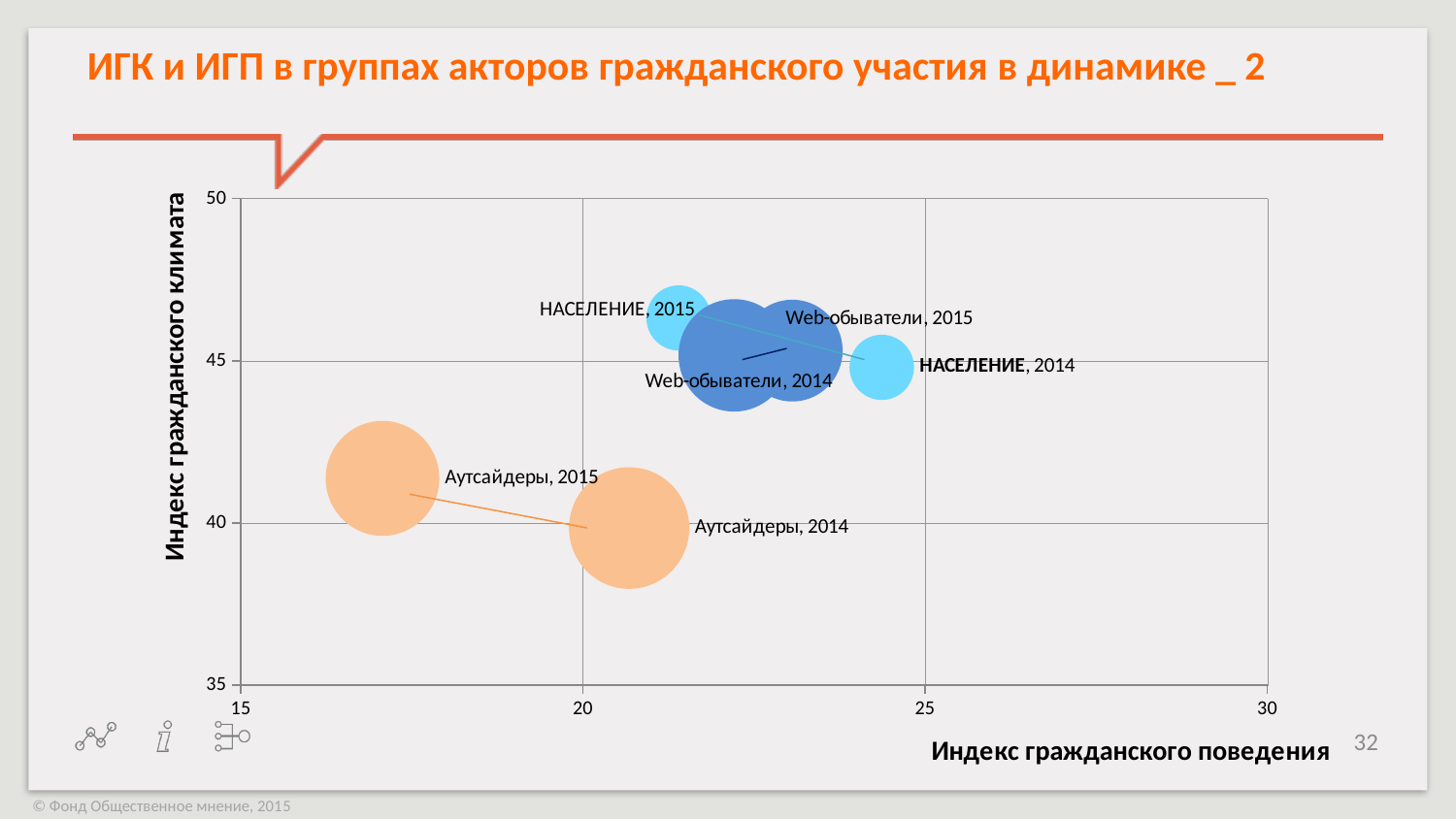
Which has the larger value on the x axis: НАСЕЛЕНИЕ, 2014 or НАСЕЛЕНИЕ, 2015? НАСЕЛЕНИЕ, 2014 Is the value on the y axis for НАСЕЛЕНИЕ, 2015 greater or less than 45? greater Is the value on the x axis (Индекс гражданского поведения) for Аутсайдеры, 2015 greater or less than 20? less Is the value on the y axis (Индекс гражданского климата) for Аутсайдеры, 2015 greater or less than 40? greater How many bubbles (data points) are plotted on the chart? 6 What kind of chart is shown on the slide? bubble chart What is the title of the horizontal axis? Индекс гражданского поведения Which bubble has the lowest value on the x axis (Индекс гражданского поведения)? Аутсайдеры, 2015 Which bubble has the lowest value on the y axis (Индекс гражданского климата)? Аутсайдеры, 2014 Which has the larger value on the x axis: Аутсайдеры, 2014 or Аутсайдеры, 2015? Аутсайдеры, 2014